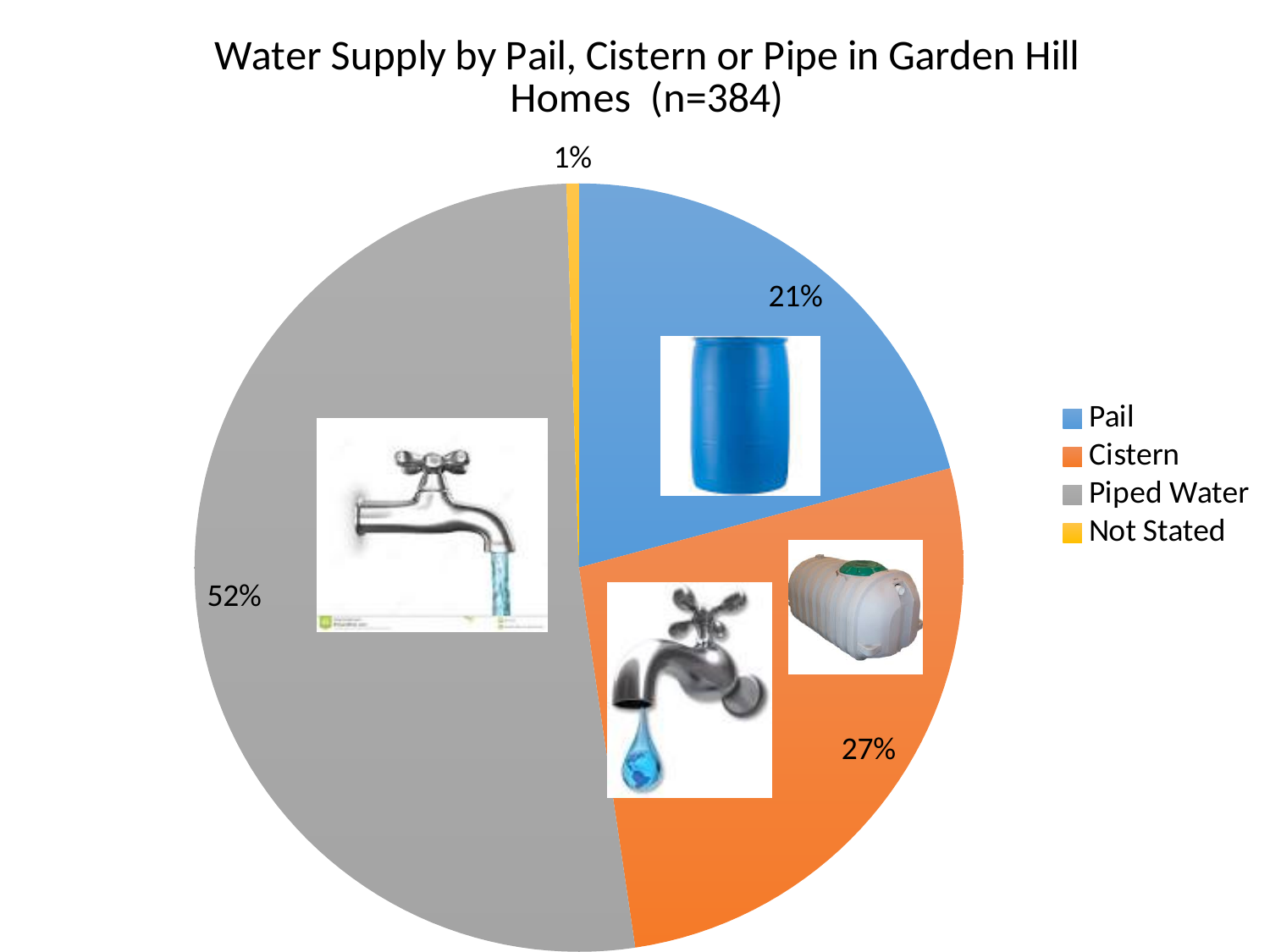
Which category has the largest share of the pie? Piped Water What percentage of homes use a Pail? 21% What kind of chart is shown on the slide? pie chart What colour represents Pail in the chart? blue How many categories does the legend list? 4 What percentage is labelled Not Stated? 1% What percentage of homes use a Cistern? 27% What is the difference in percentage points between Piped Water and Cistern? 25 What is the title of the chart? Water Supply by Pail, Cistern or Pipe in Garden Hill Homes (n=384) What percentage of homes use Piped Water? 52% Which category has the smallest share of the pie? Not Stated Which is larger, the share for Cistern or the share for Pail? Cistern